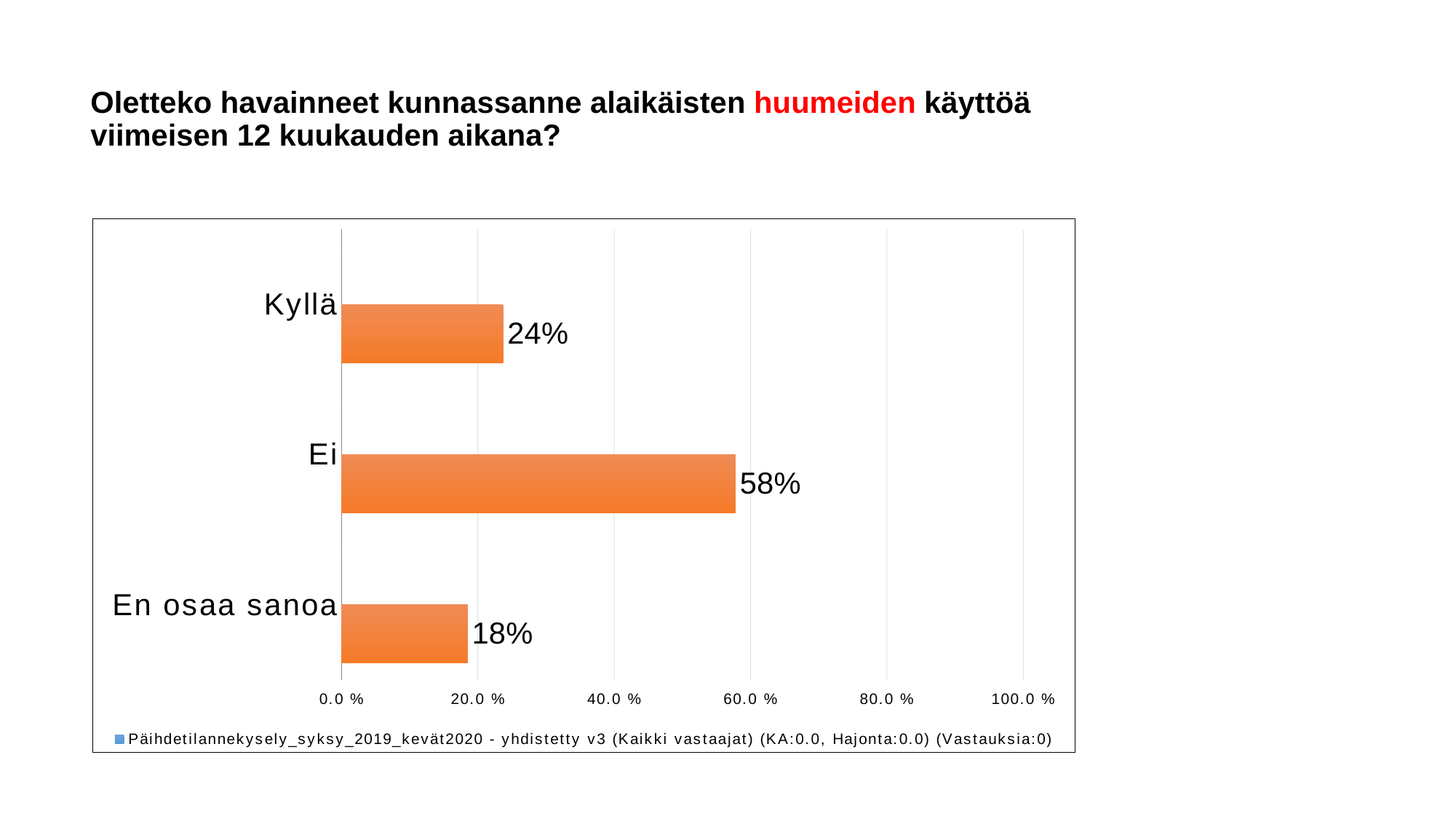
Which is larger, the value for Kyllä or the value for En osaa sanoa? Kyllä What kind of chart is shown on the slide? bar chart Is the value for Ei greater or less than 40.0 %? greater What is the value for En osaa sanoa? 18% What is the difference between the values for Kyllä and En osaa sanoa? 6% Which category has the lowest value? En osaa sanoa How many categories are shown in the chart? 3 What is the value for Kyllä? 24% What is the difference between the values for Ei and Kyllä? 34% Which category has the highest value? Ei How many series does the legend list? 1 What is the value for Ei? 58%